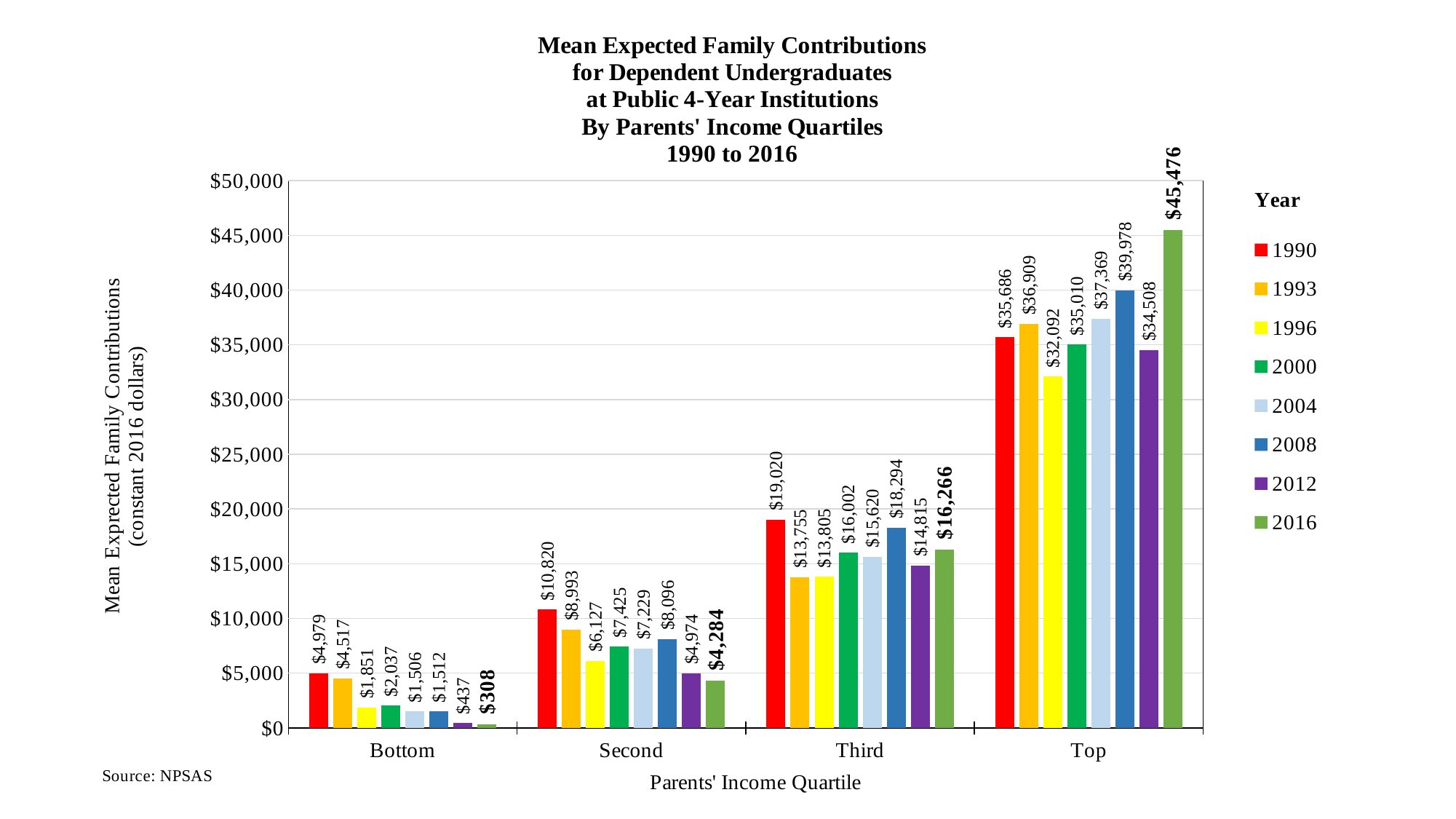
How many income quartile categories are shown on the x axis? 4 Which year has the highest value in the Third quartile? 1990 What is the difference between the 2016 and 1990 values for the Top quartile? $9,790 What is the value for the Second quartile in 2008? $8,096 What kind of chart is shown on the slide? bar chart Is the value for the Top quartile in 1996 greater or less than $30,000? greater Which is larger for the Second quartile: the 1993 value or the 2000 value? 1993 How many years does the legend list? 8 What is the mean expected family contribution for the Bottom quartile in 1990? $4,979 Which year has the lowest value in the Bottom quartile? 2016 What is the value for the Third quartile in 2012? $14,815 What is the mean expected family contribution for the Top quartile in 2016? $45,476